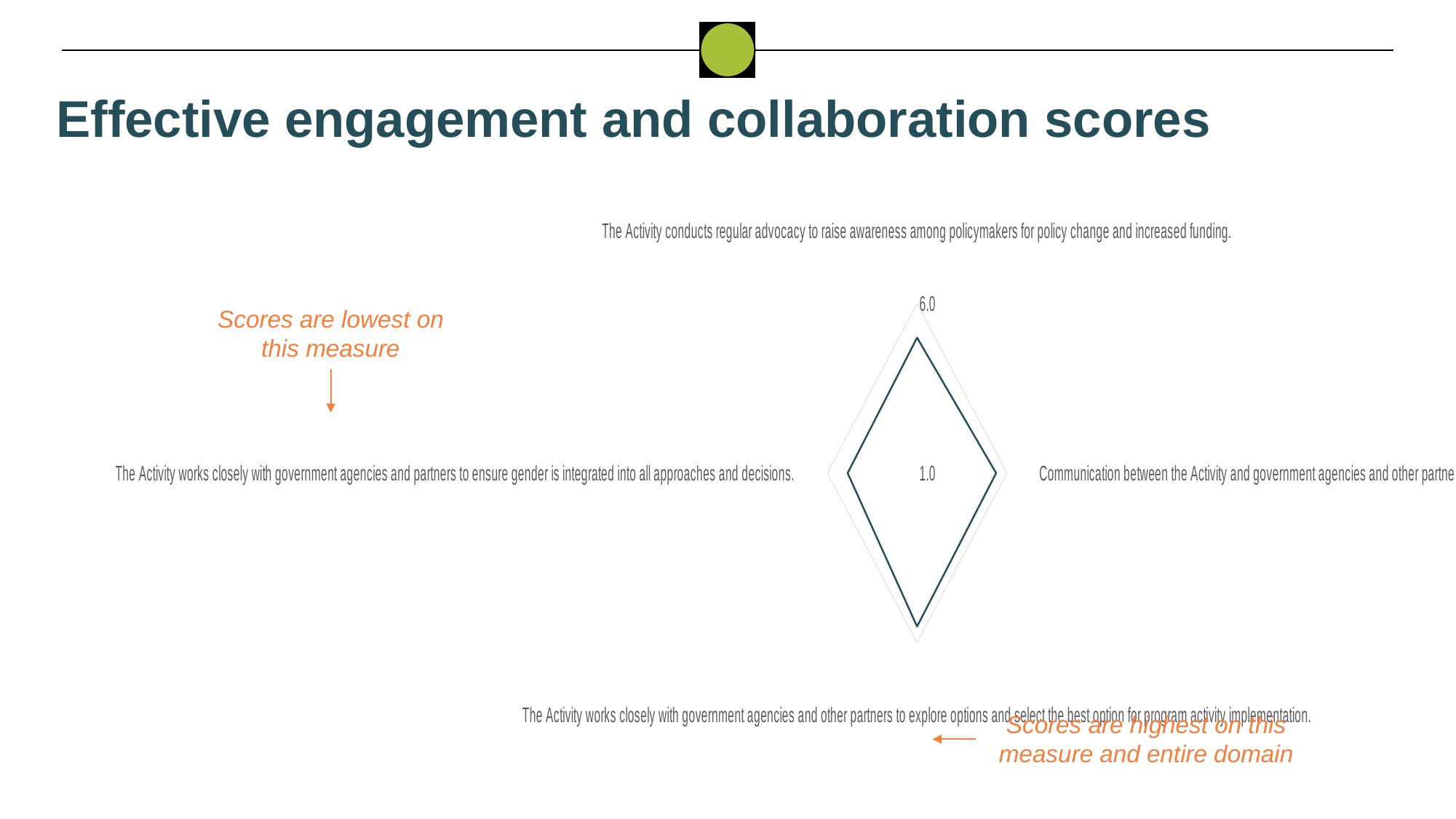
According to the slide, on which measure are scores lowest? The Activity works closely with government agencies and partners to ensure gender is integrated into all approaches and decisions. Is the score for 'The Activity works closely with government agencies and partners to ensure gender is integrated into all approaches and decisions' greater or less than 1.0? greater Is the score for the measure about exploring options and selecting the best option for program activity implementation greater or less than 1.0? greater What kind of chart is shown on the slide? radar chart What is the highest value shown on the radar chart's axis scale? 6.0 How many measures (axes) does the radar chart plot? 4 According to the slide, on which measure are scores highest? The Activity works closely with government agencies and other partners to explore options and select the best option for program activity implementation. Which measure has the larger score: the gender integration measure or the measure about exploring options and selecting the best option for program activity implementation? The Activity works closely with government agencies and other partners to explore options and select the best option for program activity implementation. Is the score for 'The Activity conducts regular advocacy to raise awareness among policymakers for policy change and increased funding' greater or less than 6.0? less What is the title of the slide containing the chart? Effective engagement and collaboration scores